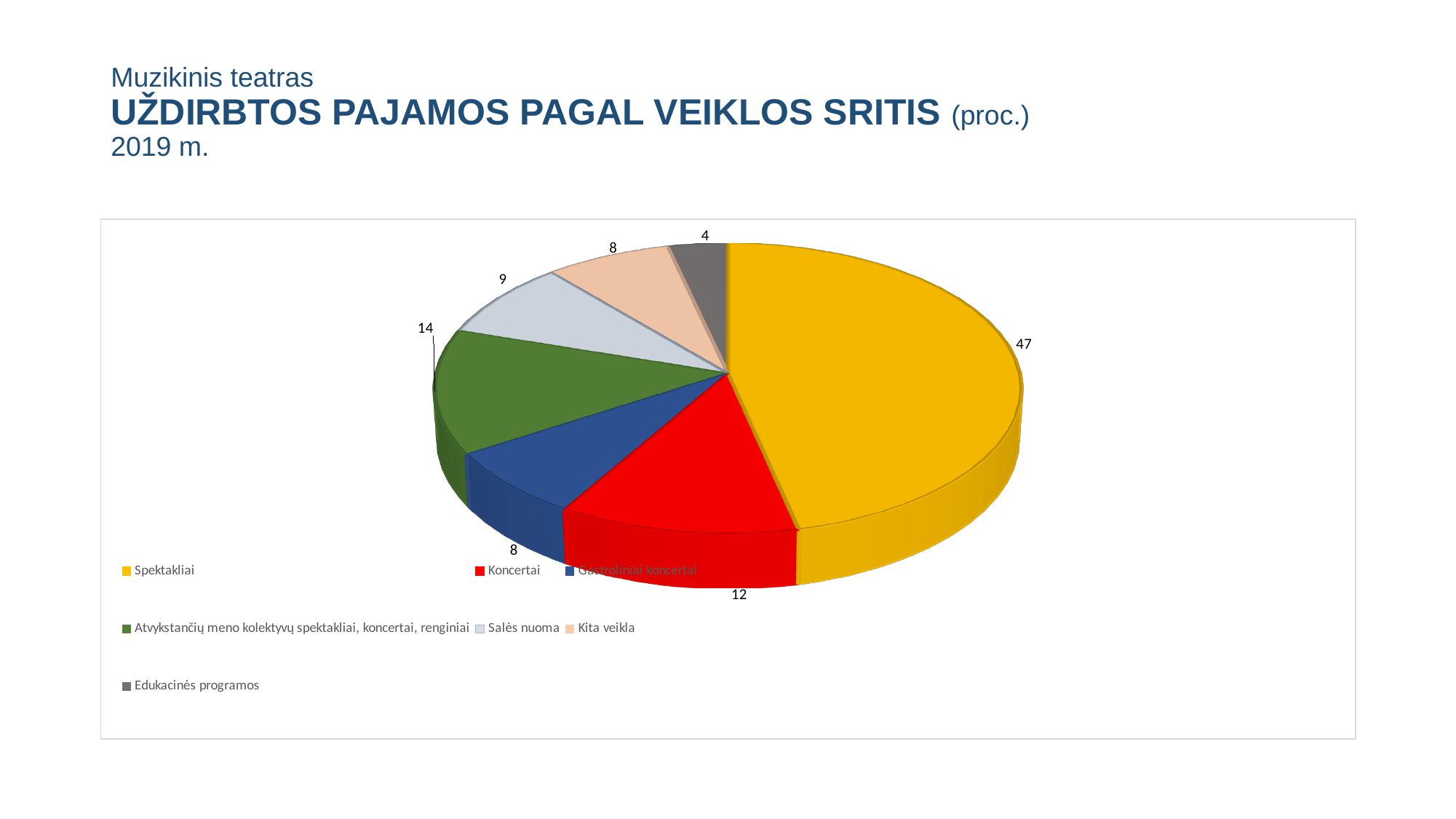
What is the value for Atvykstančių meno kolektyvų spektakliai, koncertai, renginiai? 14 Which is larger, the value for Koncertai or the value for Salės nuoma? Koncertai What kind of chart is shown on the slide? pie chart What is the value for Spektakliai? 47 What is the difference between the values for Spektakliai and Koncertai? 35 How many categories does the pie chart have? 7 Which category has the largest slice? Spektakliai What is the value for Salės nuoma? 9 What is the value for Edukacinės programos? 4 What is the value for Koncertai? 12 Which category has the smallest slice? Edukacinės programos Which colour represents Koncertai in the chart? red